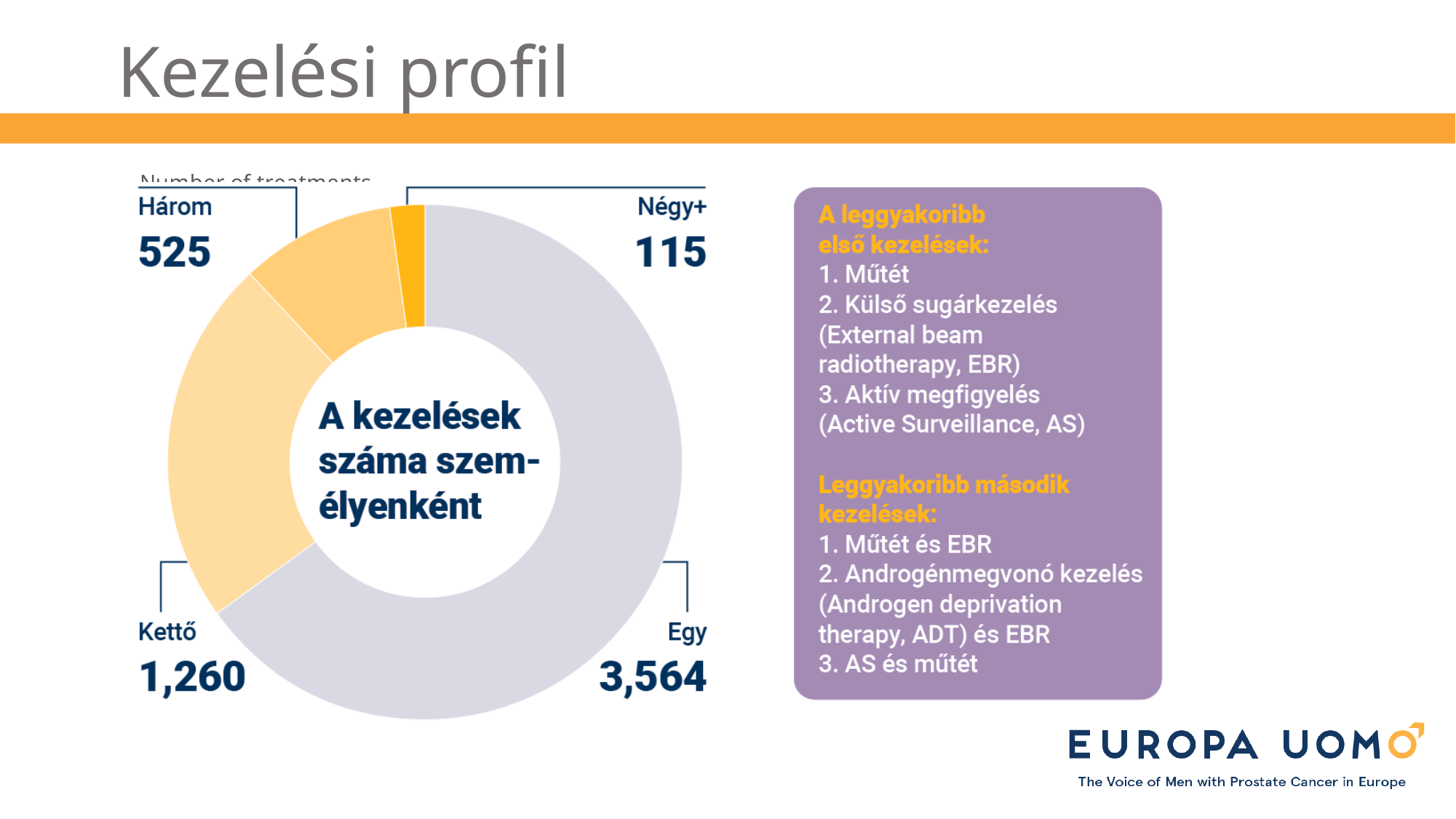
What type of chart is shown on the slide? Pie chart (donut) What text is shown in the centre of the donut chart? A kezelések száma személyenként What is the value for the "Három" category? 525 What is the value for the "Egy" category? 3,564 What is the value for the "Kettő" category? 1,260 Which category has the highest value? Egy What is the value for the "Négy+" category? 115 What is the total of all four categories in the donut chart? 5,464 Which is larger, the value for "Három" or the value for "Négy+"? Három How many categories does the donut chart show? 4 What is the difference between the values for "Egy" and "Kettő"? 2,304 Which category has the lowest value? Négy+